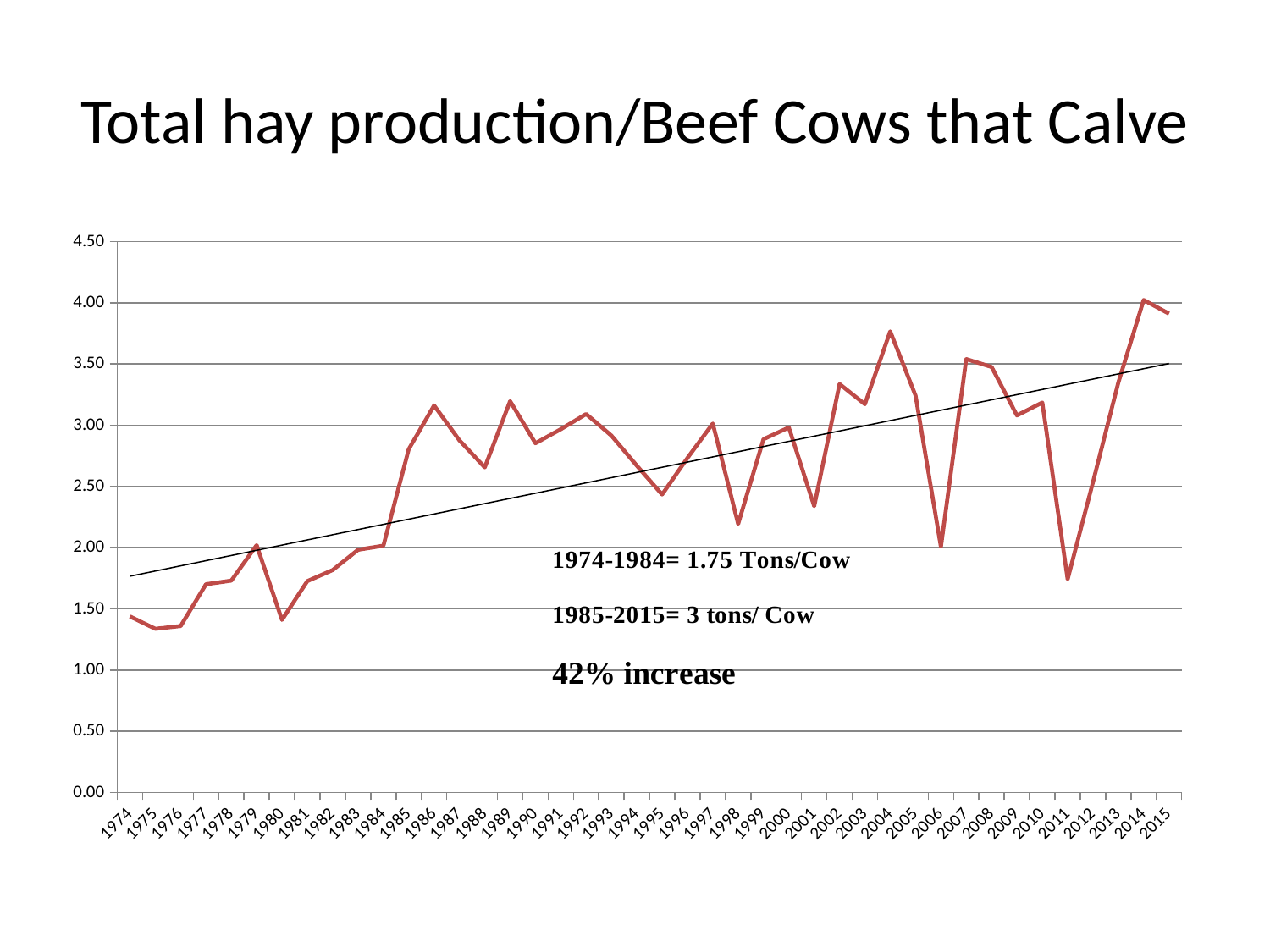
Which year has the larger value, 1974 or 2014? 2014 Overall, do the values rise or fall from 1974 to 2015? rise Which year has the highest value on the chart? 2014 What is the title of the chart? Total hay production/Beef Cows that Calve According to the annotation on the chart, what is the average for 1985-2015? 3 tons/ Cow What kind of chart is shown on the slide? line chart Is the value for 2004 greater or less than 3.50? greater Is the value for 2011 greater or less than 2.00? less How many years are plotted along the x axis? 42 Is the value for 1986 greater or less than 3.00? greater